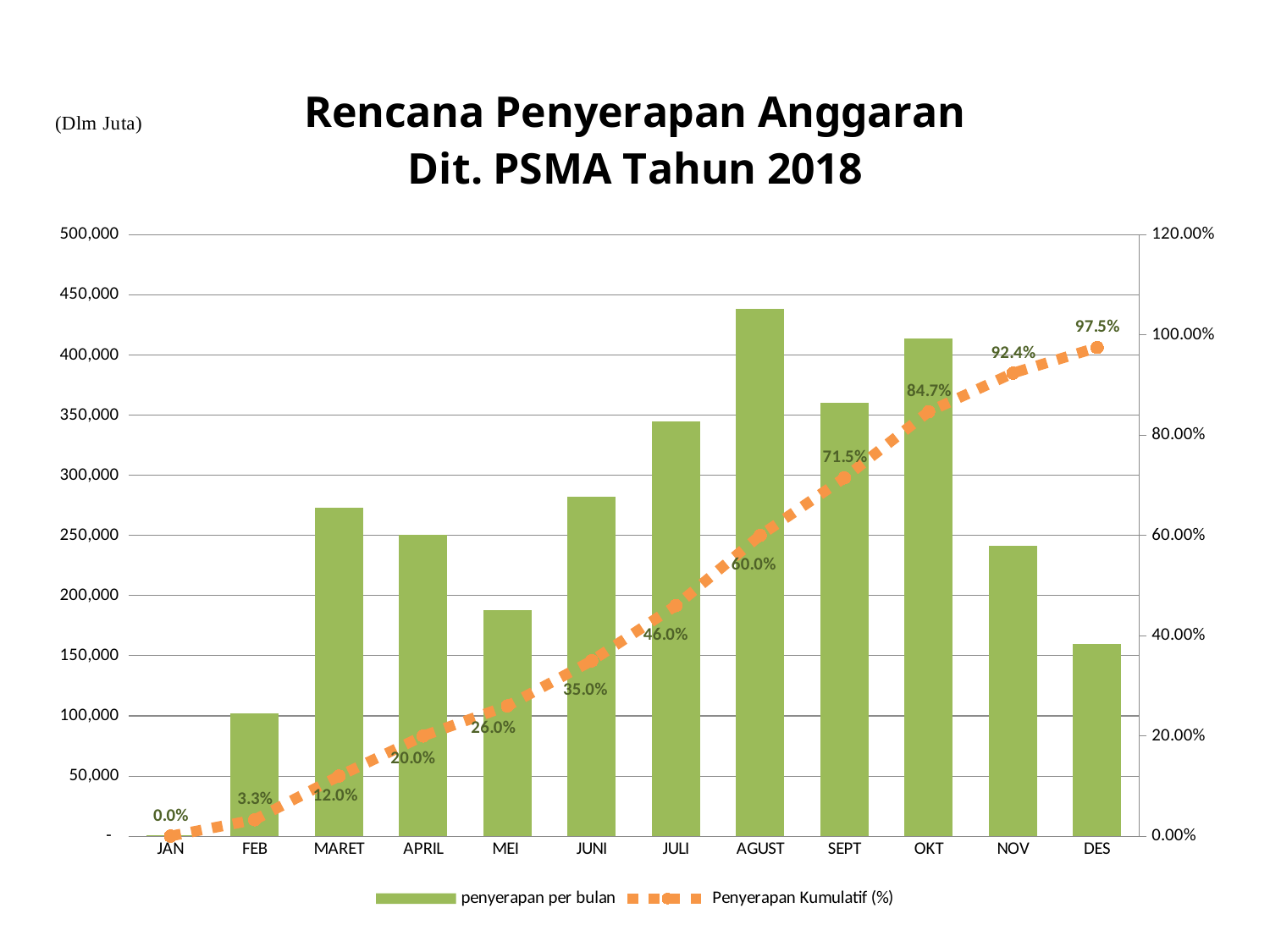
What is the difference in Penyerapan Kumulatif (%) between DES and NOV? 5.1 percentage points How many months are shown on the x axis? 12 How many series does the legend list? 2 Which month has the lowest penyerapan per bulan bar? JAN What is the Penyerapan Kumulatif (%) value for DES? 97.5% What is the Penyerapan Kumulatif (%) value for MARET? 12.0% Which month has the highest penyerapan per bulan bar? AGUST Which month has a larger penyerapan per bulan bar, OKT or SEPT? OKT Does the Penyerapan Kumulatif (%) line rise or fall from JAN to DES? rise What is the Penyerapan Kumulatif (%) value for AGUST? 60.0% Is the penyerapan per bulan value for AGUST greater or less than 400,000? greater Is the penyerapan per bulan value for DES greater or less than 200,000? less